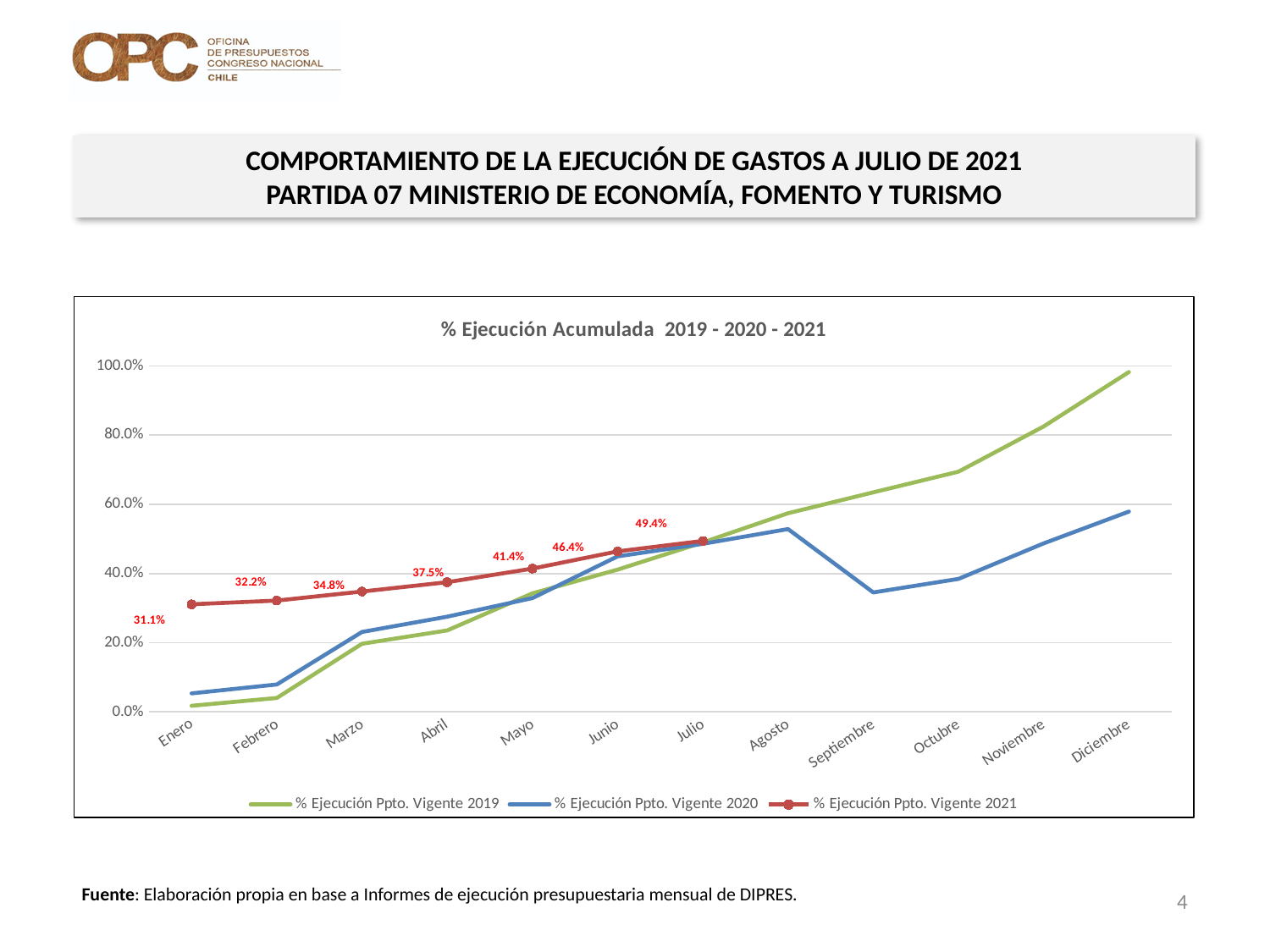
In which month does the % Ejecución Ppto. Vigente 2021 series reach its highest value? Julio What is the value of % Ejecución Ppto. Vigente 2021 for Abril? 37.5% In which month does the % Ejecución Ppto. Vigente 2021 series have its lowest value? Enero What kind of chart is shown on the slide? Line chart What is the difference between the % Ejecución Ppto. Vigente 2021 values for Julio and Enero? 18.3% What is the value of % Ejecución Ppto. Vigente 2021 for Enero? 31.1% What is the value of % Ejecución Ppto. Vigente 2021 for Mayo? 41.4% What is the value of % Ejecución Ppto. Vigente 2021 for Julio? 49.4% What is the difference between the % Ejecución Ppto. Vigente 2021 values for Junio and Mayo? 5.0% Is the value of % Ejecución Ppto. Vigente 2020 for Septiembre greater or less than 40.0%? less Is the value of % Ejecución Ppto. Vigente 2019 for Diciembre greater or less than 80.0%? greater How many series does the legend list? 3